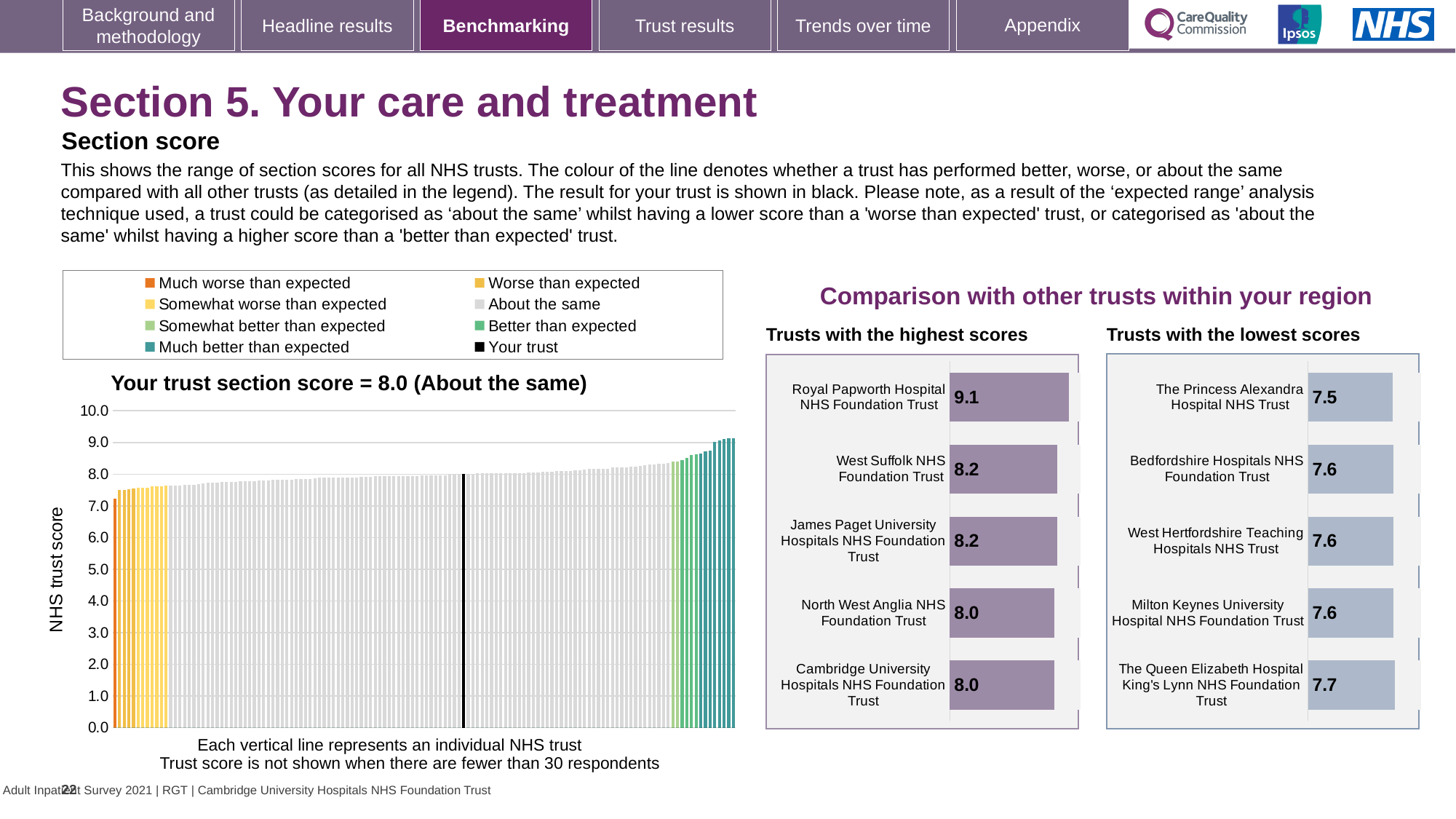
In the main chart on the left showing the range of section scores, what is your trust's section score? 8.0 In the main chart on the left showing the range of section scores, do the trust scores rise or fall from left to right? rise In the 'Trusts with the highest scores' chart, what is the score for West Suffolk NHS Foundation Trust? 8.2 In the 'Trusts with the highest scores' chart, what is the score for Royal Papworth Hospital NHS Foundation Trust? 9.1 In the 'Trusts with the highest scores' chart, how many trusts are listed? 5 In the 'Trusts with the highest scores' chart, which trust has the highest score? Royal Papworth Hospital NHS Foundation Trust In the 'Trusts with the lowest scores' chart, what is the difference between the scores of The Queen Elizabeth Hospital King's Lynn NHS Foundation Trust and The Princess Alexandra Hospital NHS Trust? 0.2 In the 'Trusts with the lowest scores' chart, what is the score for The Princess Alexandra Hospital NHS Trust? 7.5 In the 'Trusts with the highest scores' chart, what is the difference between the scores of Royal Papworth Hospital NHS Foundation Trust and Cambridge University Hospitals NHS Foundation Trust? 0.9 In the 'Trusts with the lowest scores' chart, what is the score for The Queen Elizabeth Hospital King's Lynn NHS Foundation Trust? 7.7 Which is larger: the score for Royal Papworth Hospital NHS Foundation Trust in the highest scores chart, or the score for Bedfordshire Hospitals NHS Foundation Trust in the lowest scores chart? Royal Papworth Hospital NHS Foundation Trust In the 'Trusts with the lowest scores' chart, which trust has the lowest score? The Princess Alexandra Hospital NHS Trust